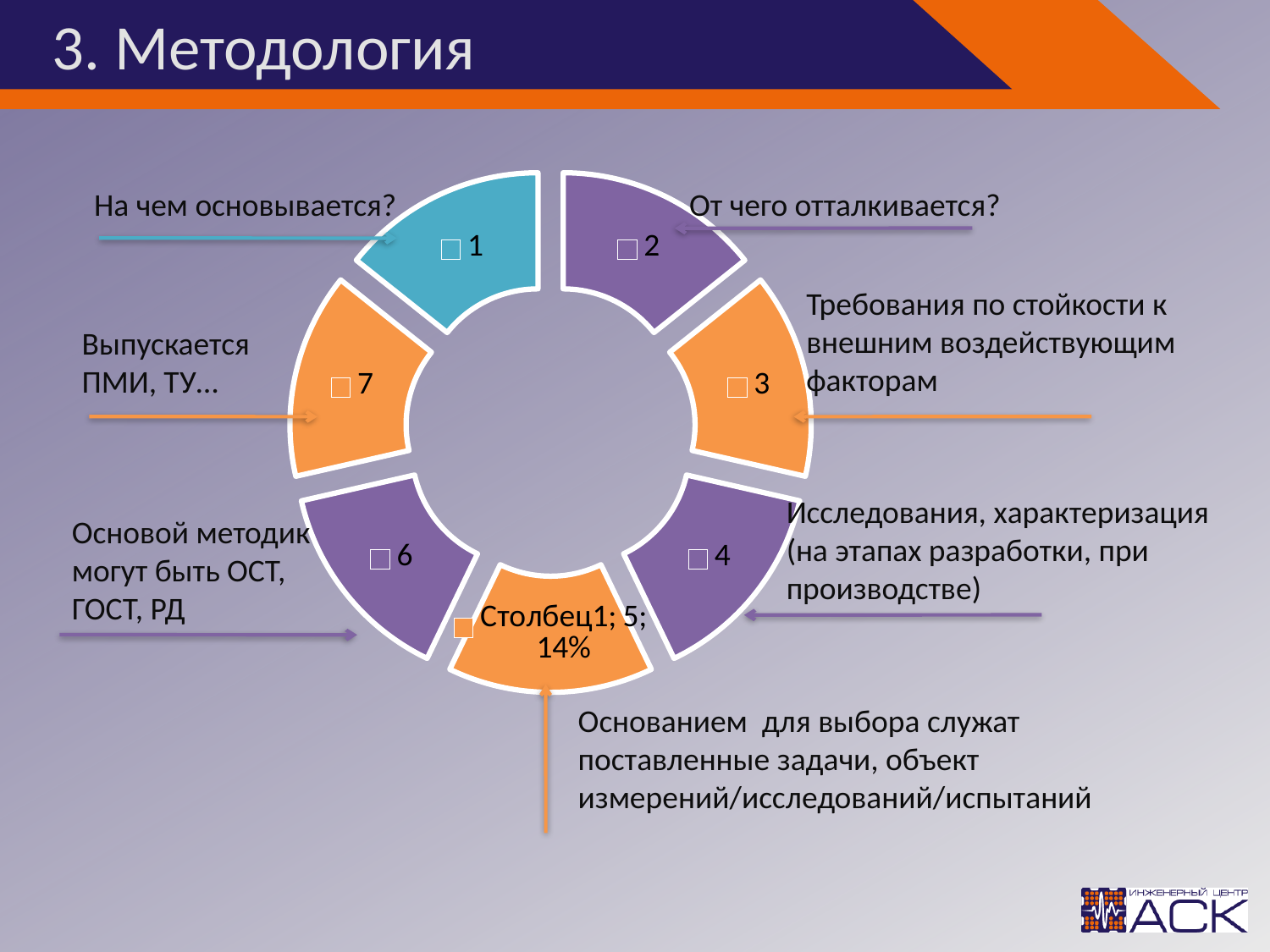
How many segments does the doughnut chart have? 7 What share of the doughnut does segment 5 represent, according to its data label? 14% What series name is printed in the data label of segment 5? Столбец1 What colour is segment 1 of the doughnut chart? Teal (blue) Which segment of the doughnut chart carries the label '14%'? 5 What kind of chart is shown on the slide? Doughnut (pie) chart